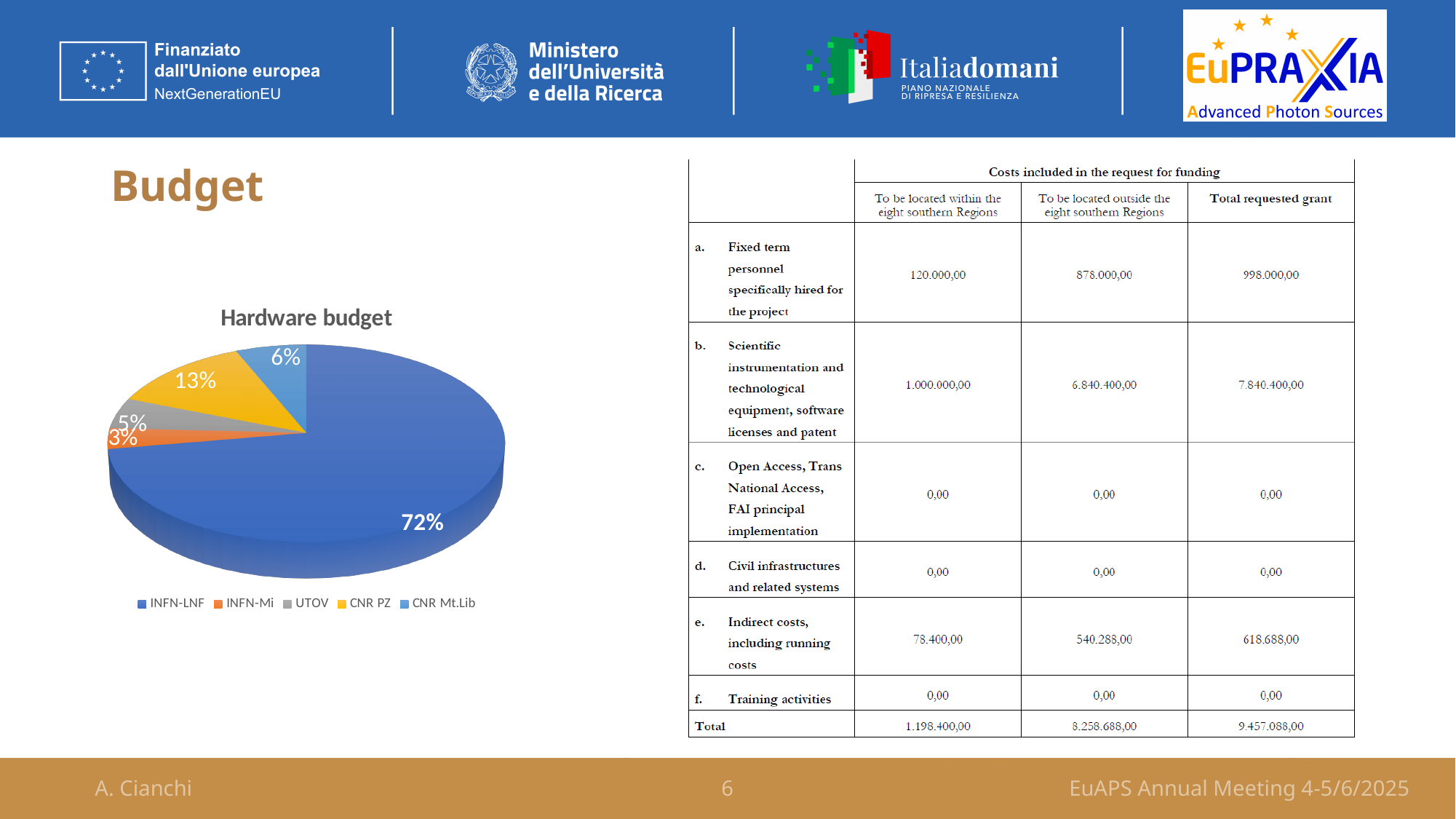
What is the title of the chart on the slide? Hardware budget In the Hardware budget pie chart, what share does CNR Mt.Lib have? 6% In the Hardware budget pie chart, what share does INFN-Mi have? 3% What kind of chart is the Hardware budget chart? pie chart In the Hardware budget pie chart, which is larger: the share for CNR PZ or the share for CNR Mt.Lib? CNR PZ Which category has the smallest slice in the Hardware budget pie chart? INFN-Mi Which category has the largest slice in the Hardware budget pie chart? INFN-LNF In the Hardware budget pie chart, what is the difference between the INFN-LNF share and the CNR PZ share? 59% In the Hardware budget pie chart, what share does UTOV have? 5% How many categories does the Hardware budget pie chart show? 5